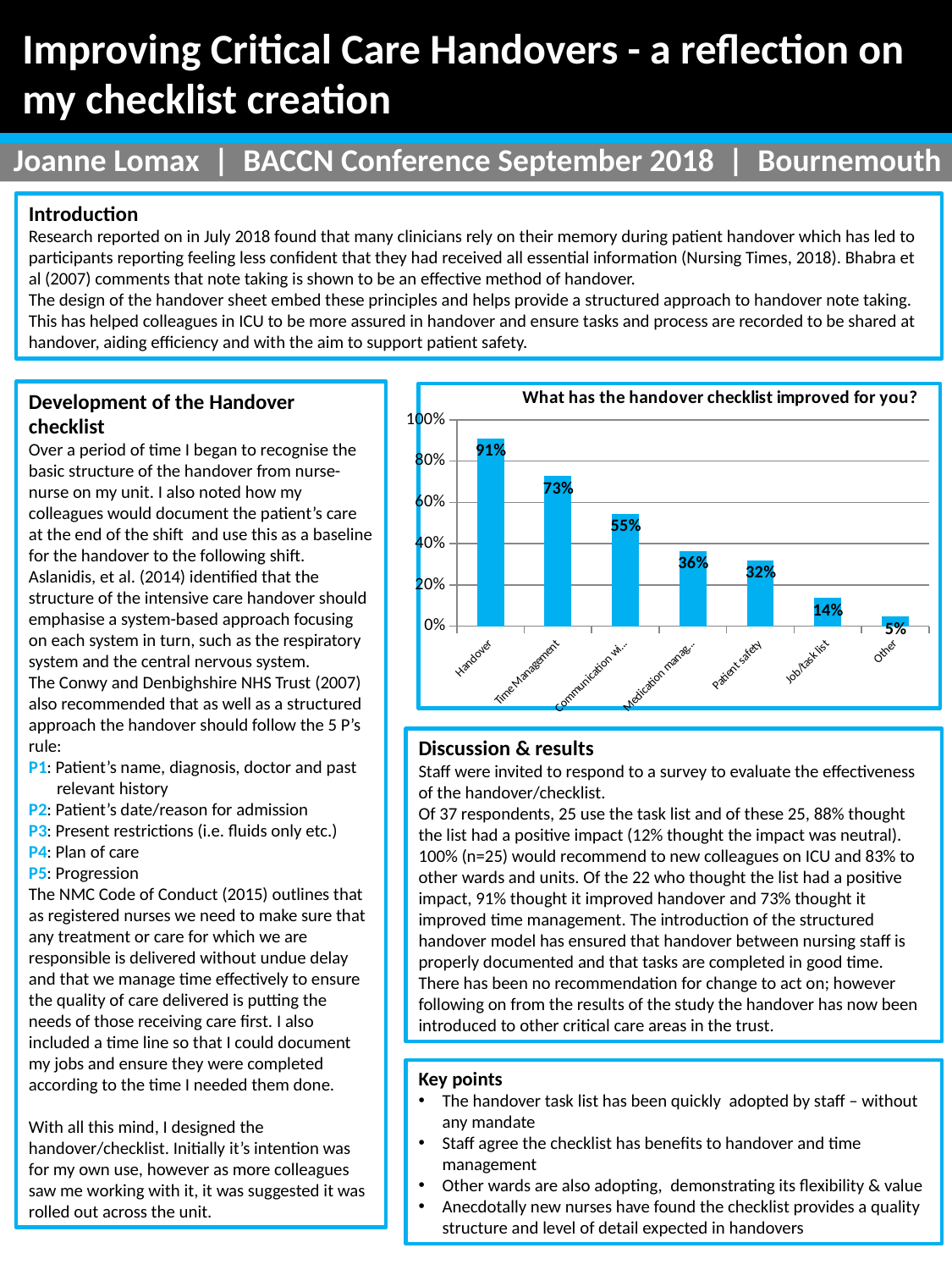
Which category has the highest value in the chart? Handover How many categories are shown in the chart? 7 What is the value for Job/task list in the chart? 14% What kind of chart is shown on the slide? Bar chart What is the difference between the values for Handover and Time Management? 18% Which is larger, the value for Patient safety or the value for Job/task list? Patient safety What is the value for Other in the chart? 5% Which category has the lowest value in the chart? Other What is the value for Handover in the chart? 91% What is the value for Time Management in the chart? 73% What is the value for Patient safety in the chart? 32% What is the title of the chart? What has the handover checklist improved for you?